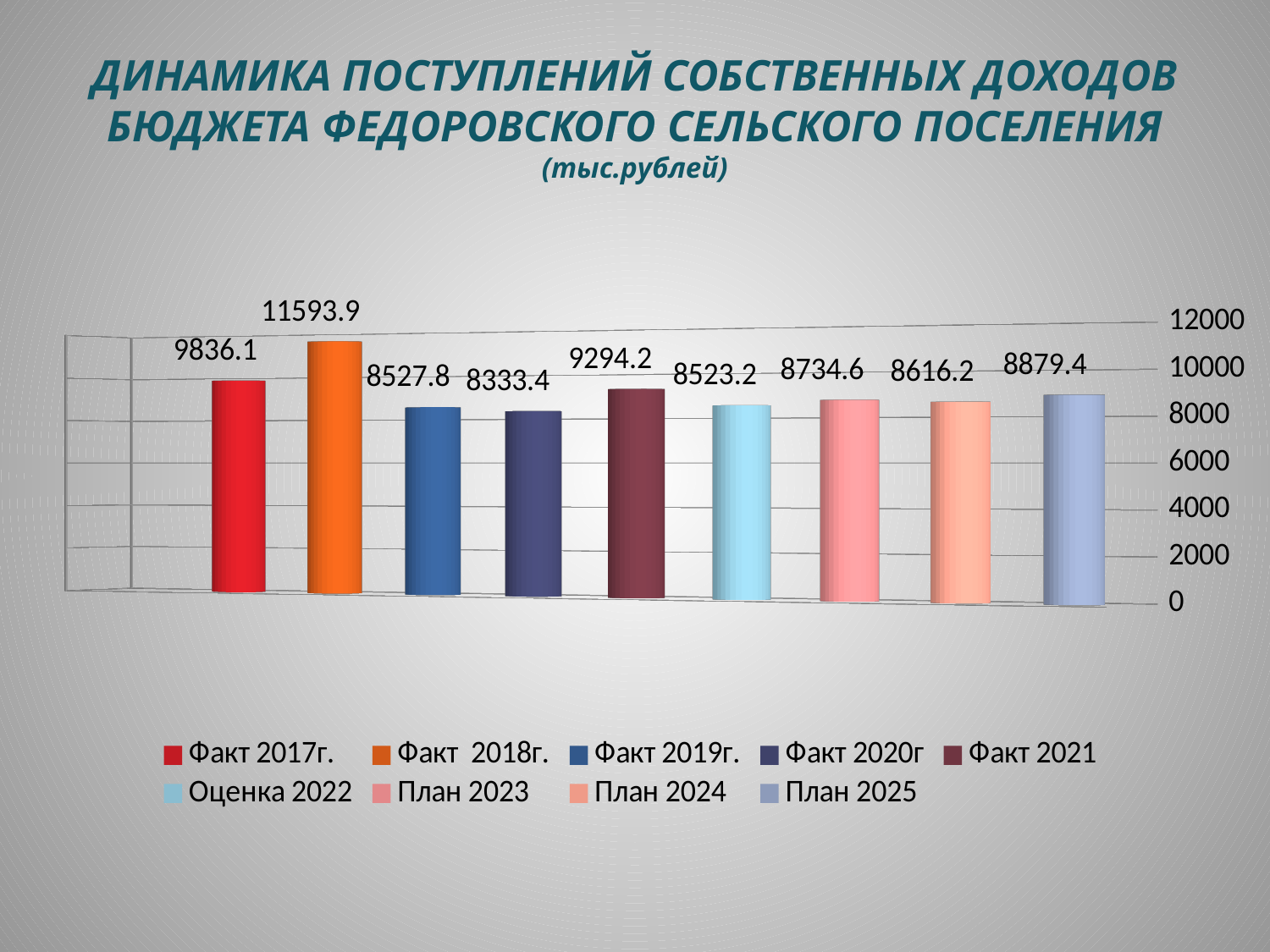
What is the value for Факт 2020г? 8333.4 How many series does the legend list? 9 Which series has the lowest value? Факт 2020г What is the difference between the values for Факт 2018г. and Факт 2017г.? 1757.8 Which series has the highest value? Факт 2018г. How many bars are plotted on the chart? 9 Is the value for Факт 2021 greater or less than 8000? greater What is the value for Факт 2018г.? 11593.9 Which is larger, the value for План 2023 or the value for План 2024? План 2023 What is the value for План 2025? 8879.4 What kind of chart is shown on the slide? bar chart What is the value for Оценка 2022? 8523.2